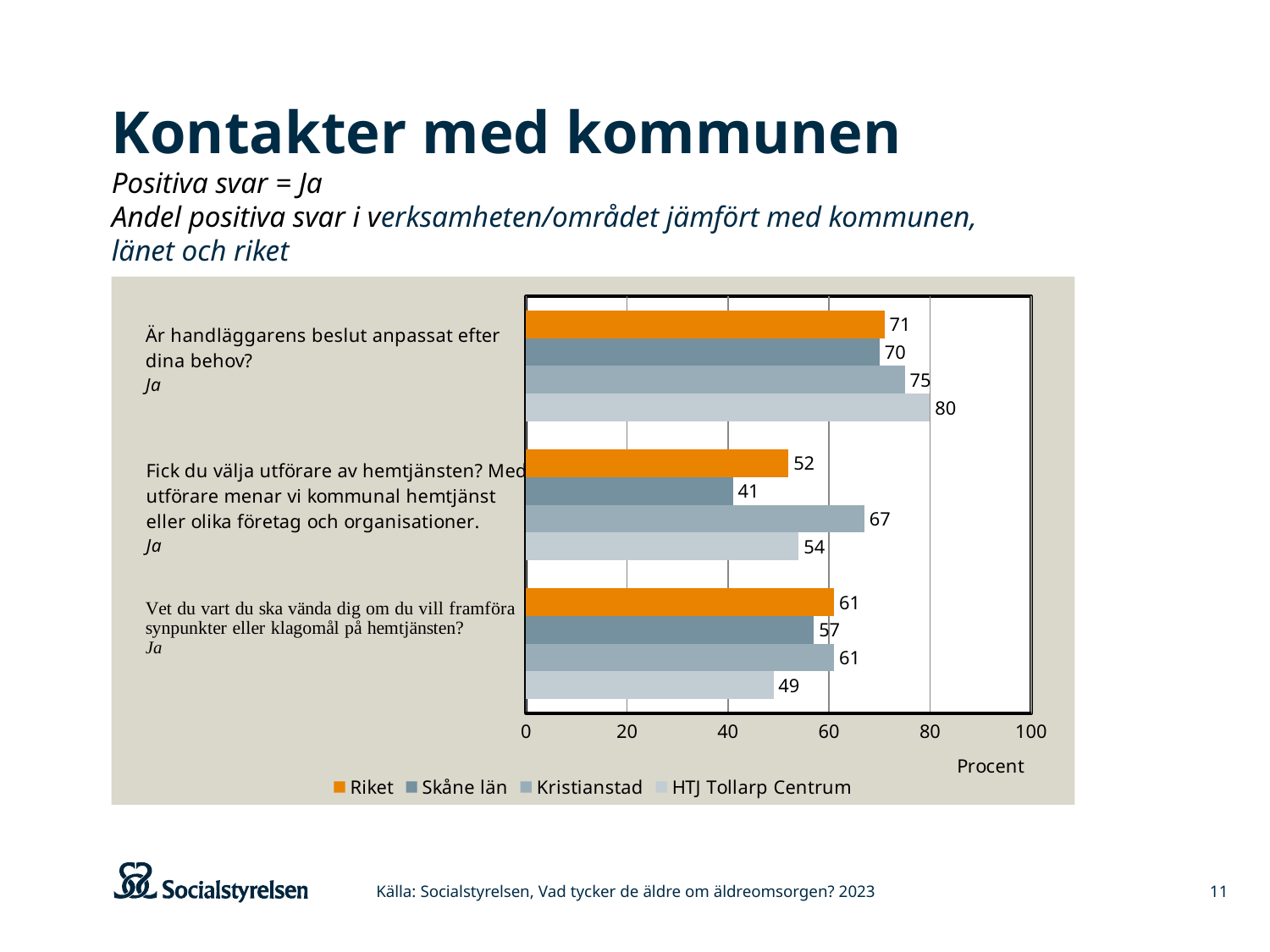
What is the value for Skåne län for the question "Fick du välja utförare av hemtjänsten?"? 41 What is the value for Riket for the question "Vet du vart du ska vända dig om du vill framföra synpunkter eller klagomål på hemtjänsten?"? 61 What is the value for HTJ Tollarp Centrum for the question "Är handläggarens beslut anpassat efter dina behov?"? 80 Is the value for Kristianstad for the question "Är handläggarens beslut anpassat efter dina behov?" greater or less than 60? greater What kind of chart is shown on the slide? Bar chart For the question "Fick du välja utförare av hemtjänsten?", which is larger: the value for Riket or the value for HTJ Tollarp Centrum? HTJ Tollarp Centrum How many question categories are plotted on the chart? 3 Which series has the lowest value for the question "Vet du vart du ska vända dig om du vill framföra synpunkter eller klagomål på hemtjänsten?"? HTJ Tollarp Centrum What unit is shown on the x axis of the chart? Procent What is the difference between the HTJ Tollarp Centrum value and the Riket value for the question "Är handläggarens beslut anpassat efter dina behov?"? 9 How many series does the legend list? 4 Which series has the highest value for the question "Fick du välja utförare av hemtjänsten?"? Kristianstad